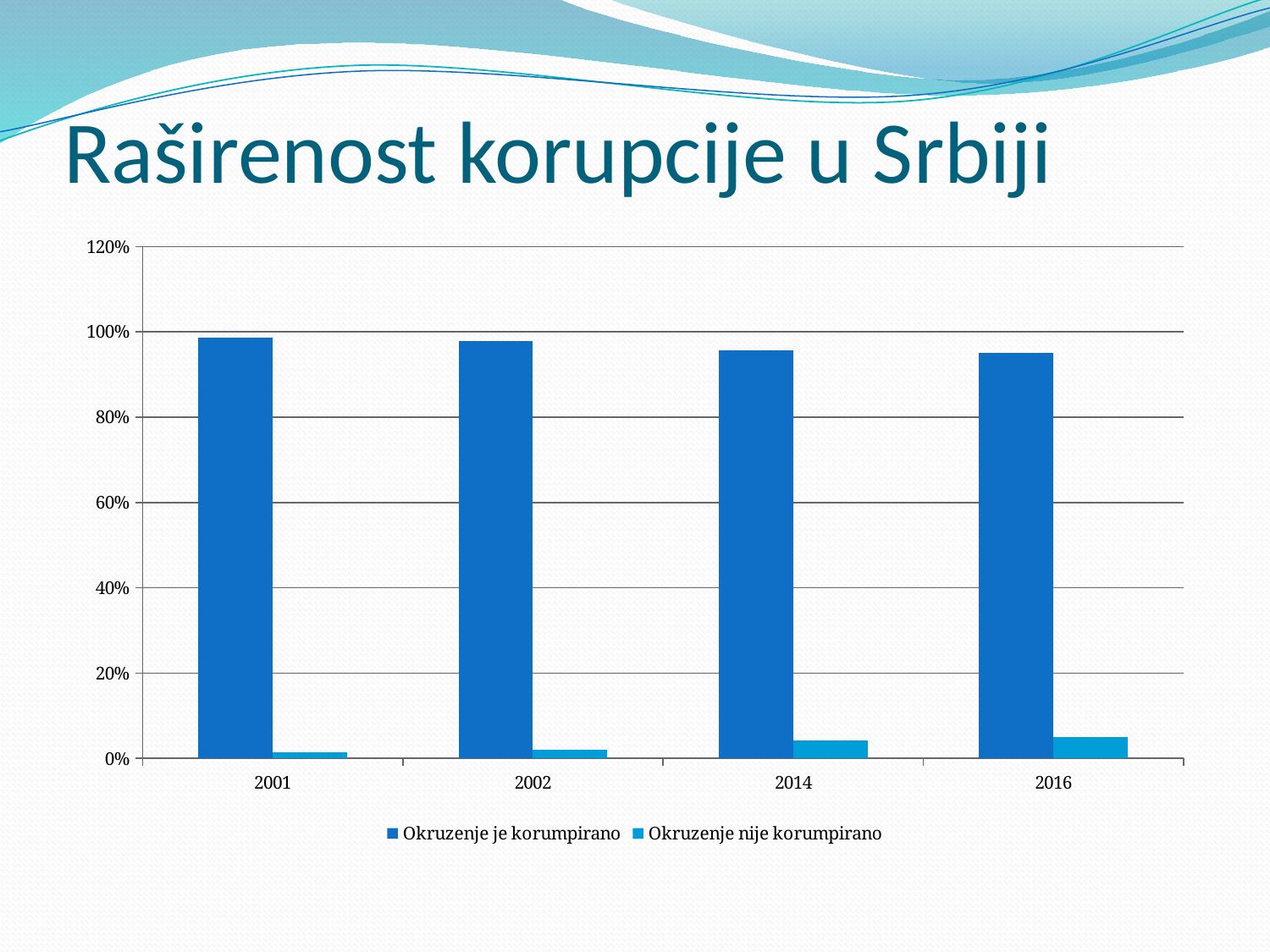
Is the value for 'Okruzenje nije korumpirano' in 2016 greater or less than 20%? less How many series does the legend list? 2 Is the value for 'Okruzenje je korumpirano' in 2001 greater or less than 80%? greater What kind of chart is shown on the slide? bar chart Which is larger: 'Okruzenje je korumpirano' in 2001 or in 2016? 2001 Is the value for 'Okruzenje je korumpirano' in 2016 greater or less than 60%? greater What is the title of the slide? Raširenost korupcije u Srbiji Which is larger: 'Okruzenje nije korumpirano' in 2001 or in 2016? 2016 Do the values for 'Okruzenje nije korumpirano' rise or fall from 2001 to 2016? rise Do the values for 'Okruzenje je korumpirano' rise or fall from 2001 to 2016? fall How many years are shown on the x axis? 4